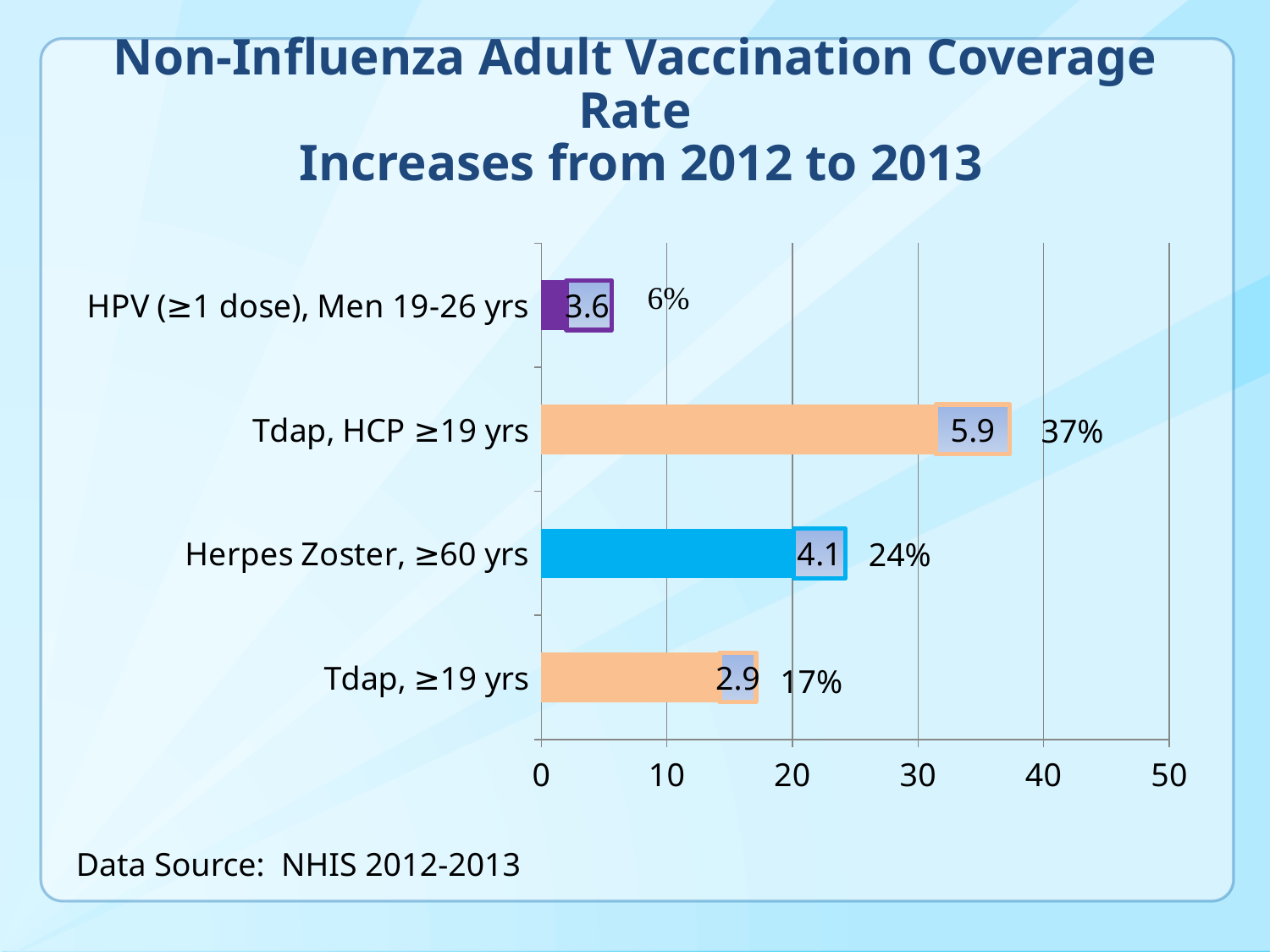
Is the bar for Herpes Zoster, ≥60 yrs greater or less than 20 on the axis? greater What is the coverage rate shown for Herpes Zoster, ≥60 yrs? 24% What type of chart is shown on the slide? Bar chart Which category has the highest coverage rate? Tdap, HCP ≥19 yrs What is the coverage rate shown for HPV (≥1 dose), Men 19-26 yrs? 6% Which category has the lowest coverage rate? HPV (≥1 dose), Men 19-26 yrs What increase value is printed in the box on the Tdap, ≥19 yrs bar? 2.9 What increase value is printed in the box on the Tdap, HCP ≥19 yrs bar? 5.9 What is the difference in coverage rate between Tdap, HCP ≥19 yrs and Tdap, ≥19 yrs? 20% What is the coverage rate shown for Tdap, HCP ≥19 yrs? 37% How many categories are shown in the chart? 4 Which has a larger coverage rate, Herpes Zoster, ≥60 yrs or Tdap, ≥19 yrs? Herpes Zoster, ≥60 yrs